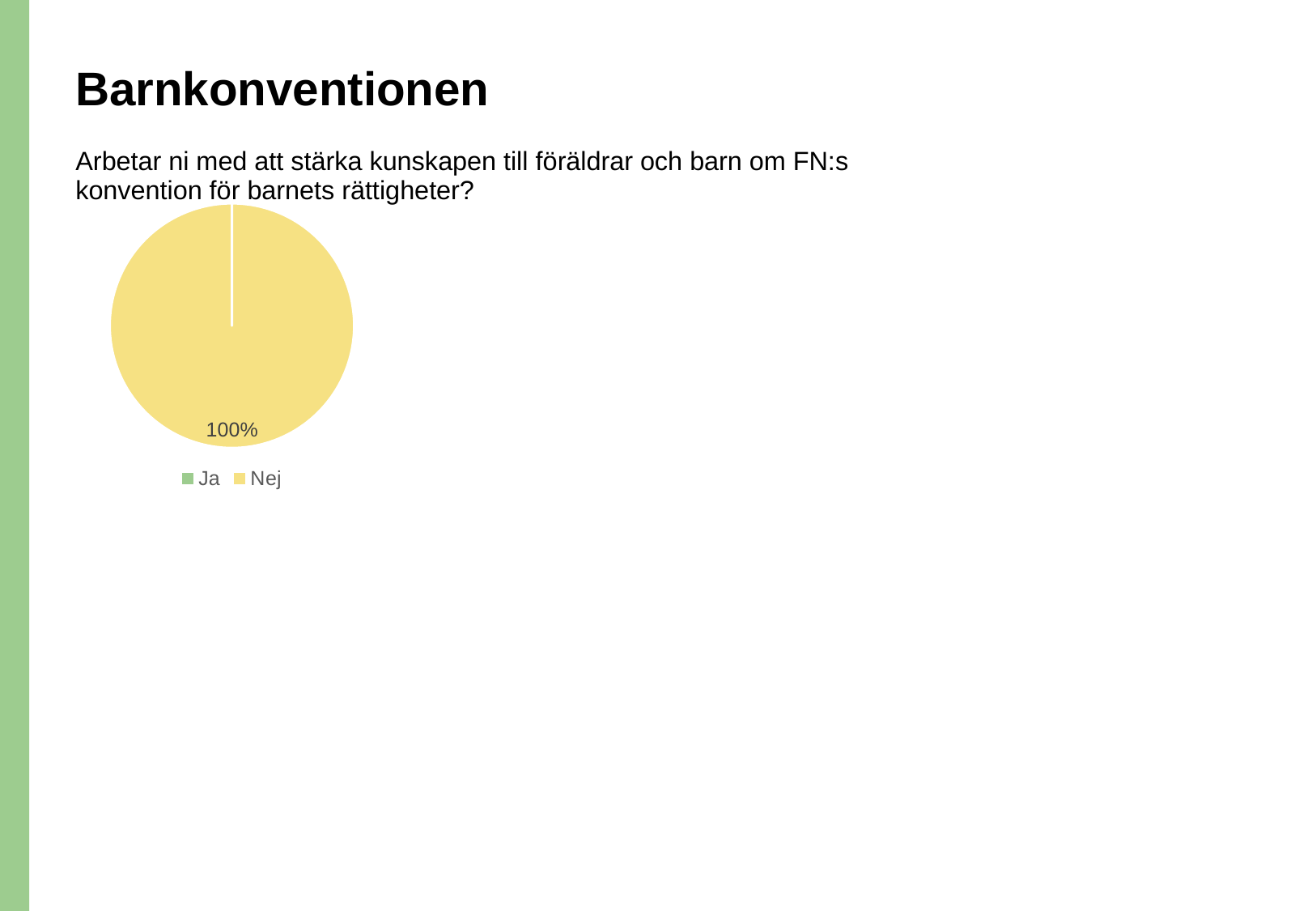
What are the two legend entries of the pie chart? Ja and Nej Which category has the largest share in the pie chart? Nej What kind of chart is shown on the slide? Pie chart How many entries does the legend of the pie chart list? 2 What share of the pie does the Nej slice take up? 100% What percentage does the Nej slice show in the pie chart? 100% Which is larger in the pie chart, Ja or Nej? Nej Is the value for Nej in the pie chart greater or less than 50%? greater What colour is the Nej slice in the pie chart? Yellow